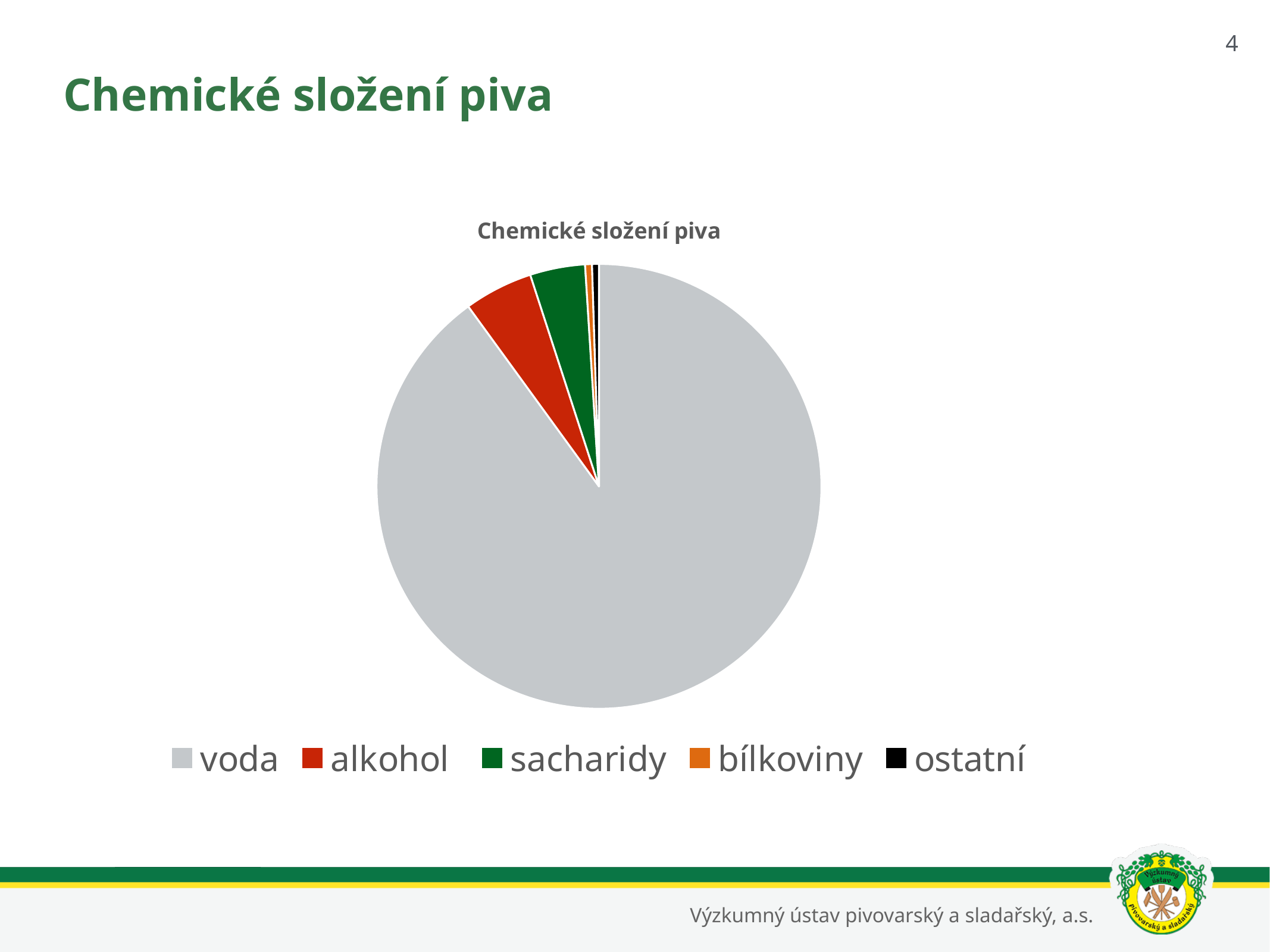
Which slice is larger, sacharidy or bílkoviny? sacharidy What is the title of the chart? Chemické složení piva Which slice is larger, alkohol or ostatní? alkohol Which slice is larger, alkohol or sacharidy? alkohol Which category has the largest slice of the pie chart? voda How many slices does the pie chart have? 5 How many categories does the legend of the pie chart list? 5 What colour is the slice for voda in the pie chart? grey What kind of chart is shown on the slide? pie chart